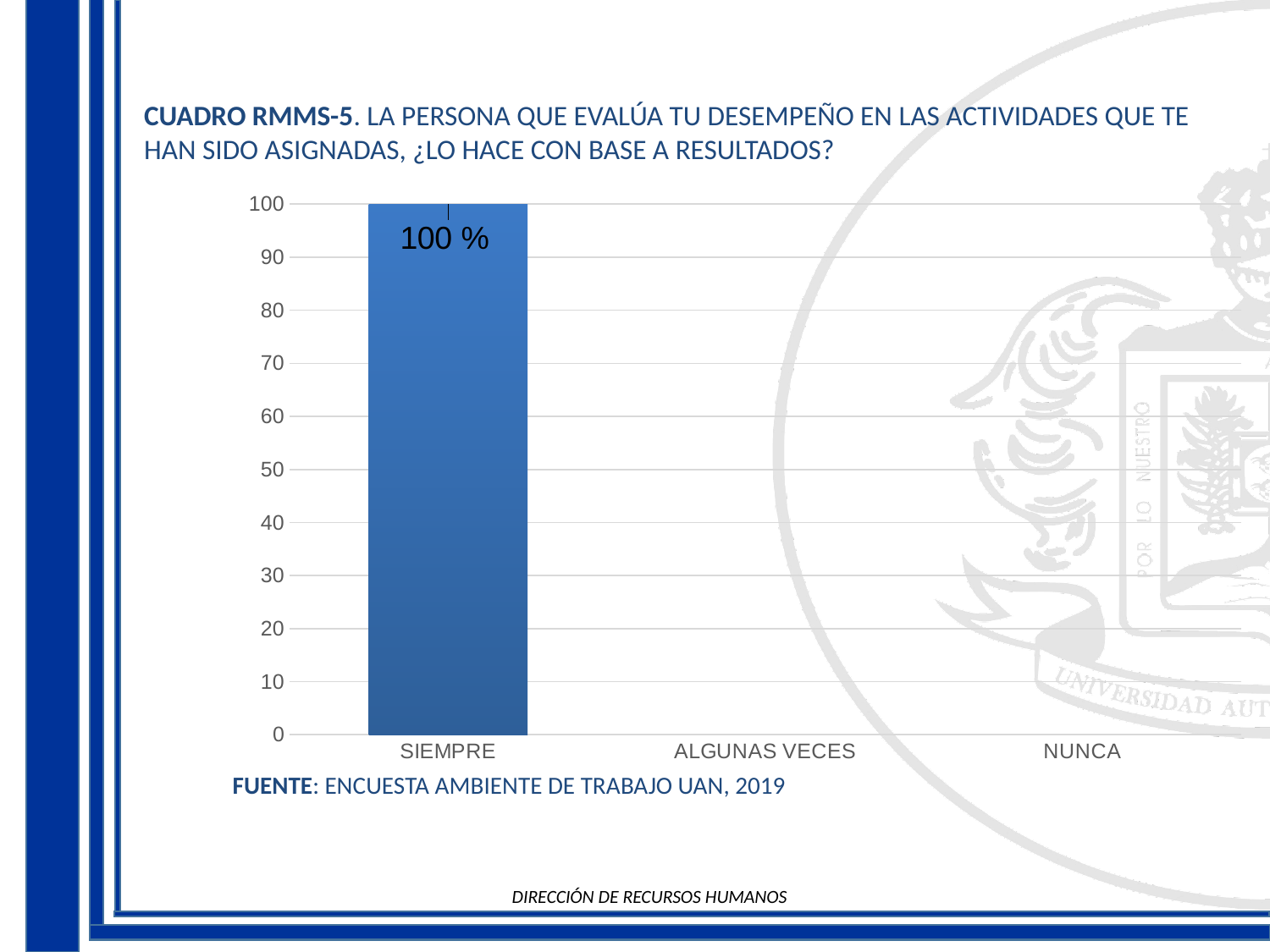
Is the value for SIEMPRE greater or less than 90? greater How many categories are shown on the x axis? 3 Which is larger, the value for ALGUNAS VECES or the value for SIEMPRE? SIEMPRE Is the value for NUNCA greater or less than 10? less What kind of chart is shown on the slide? bar chart What is the value shown for SIEMPRE? 100 % Which is larger, the value for SIEMPRE or the value for NUNCA? SIEMPRE Is the value for ALGUNAS VECES greater or less than 10? less What is the source cited below the chart? ENCUESTA AMBIENTE DE TRABAJO UAN, 2019 Which category has the highest value? SIEMPRE What is the highest value marked on the vertical axis? 100